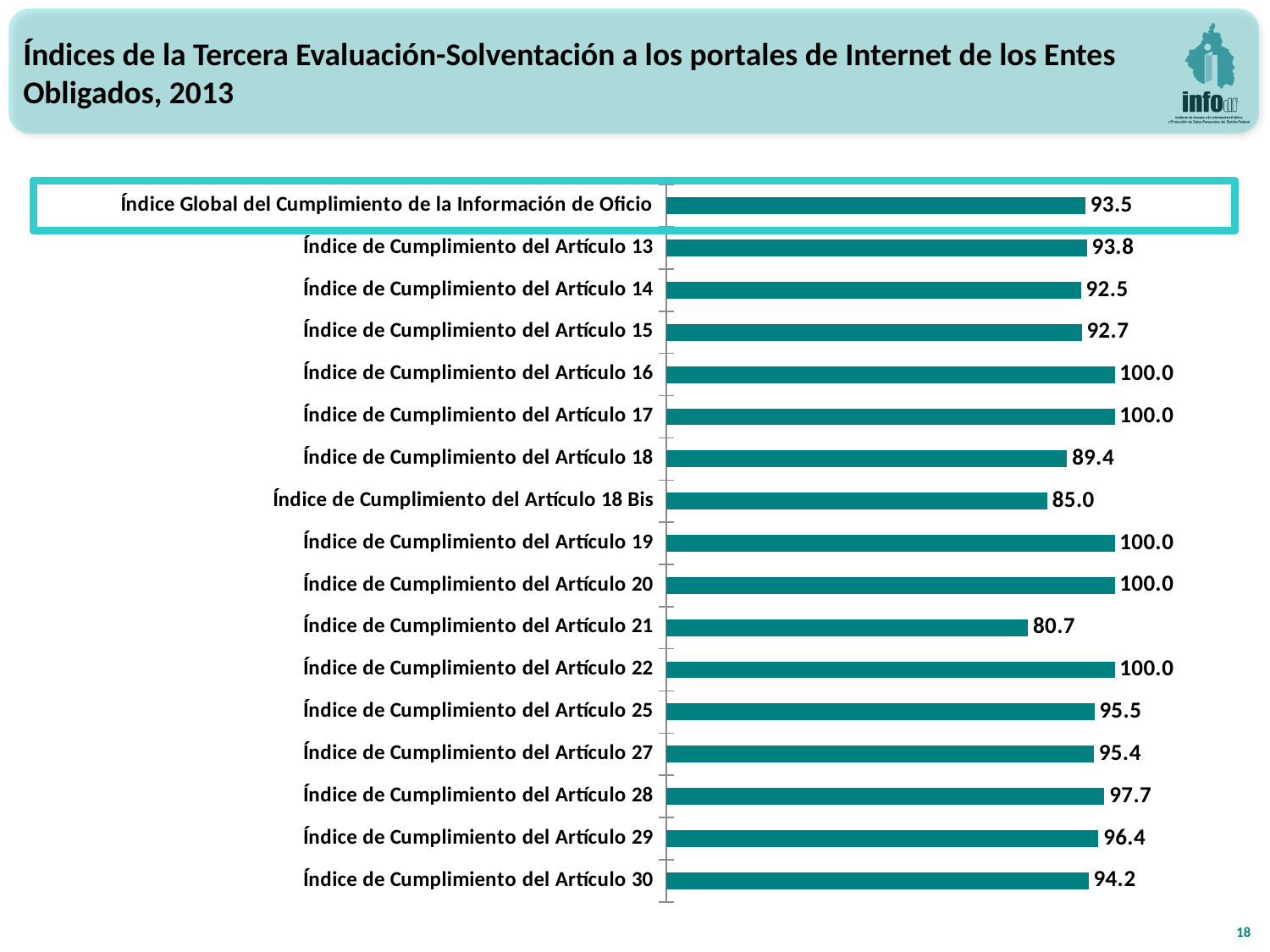
How many bars are plotted on the chart? 17 What is the difference between the values for Artículo 28 and Artículo 29? 1.3 What is the value for Índice de Cumplimiento del Artículo 18 Bis? 85.0 Which is larger, the value for Artículo 25 or the value for Artículo 30? Artículo 25 What is the highest value shown on the chart? 100.0 Which is larger, the value for Artículo 13 or the value for Artículo 14? Artículo 13 What is the difference between the values for Artículo 18 and Artículo 21? 8.7 What kind of chart is shown on the slide? Bar chart How many categories have a value of 100.0? 5 What is the value for Índice Global del Cumplimiento de la Información de Oficio? 93.5 Which category has the lowest value? Índice de Cumplimiento del Artículo 21 What is the value for Índice de Cumplimiento del Artículo 21? 80.7